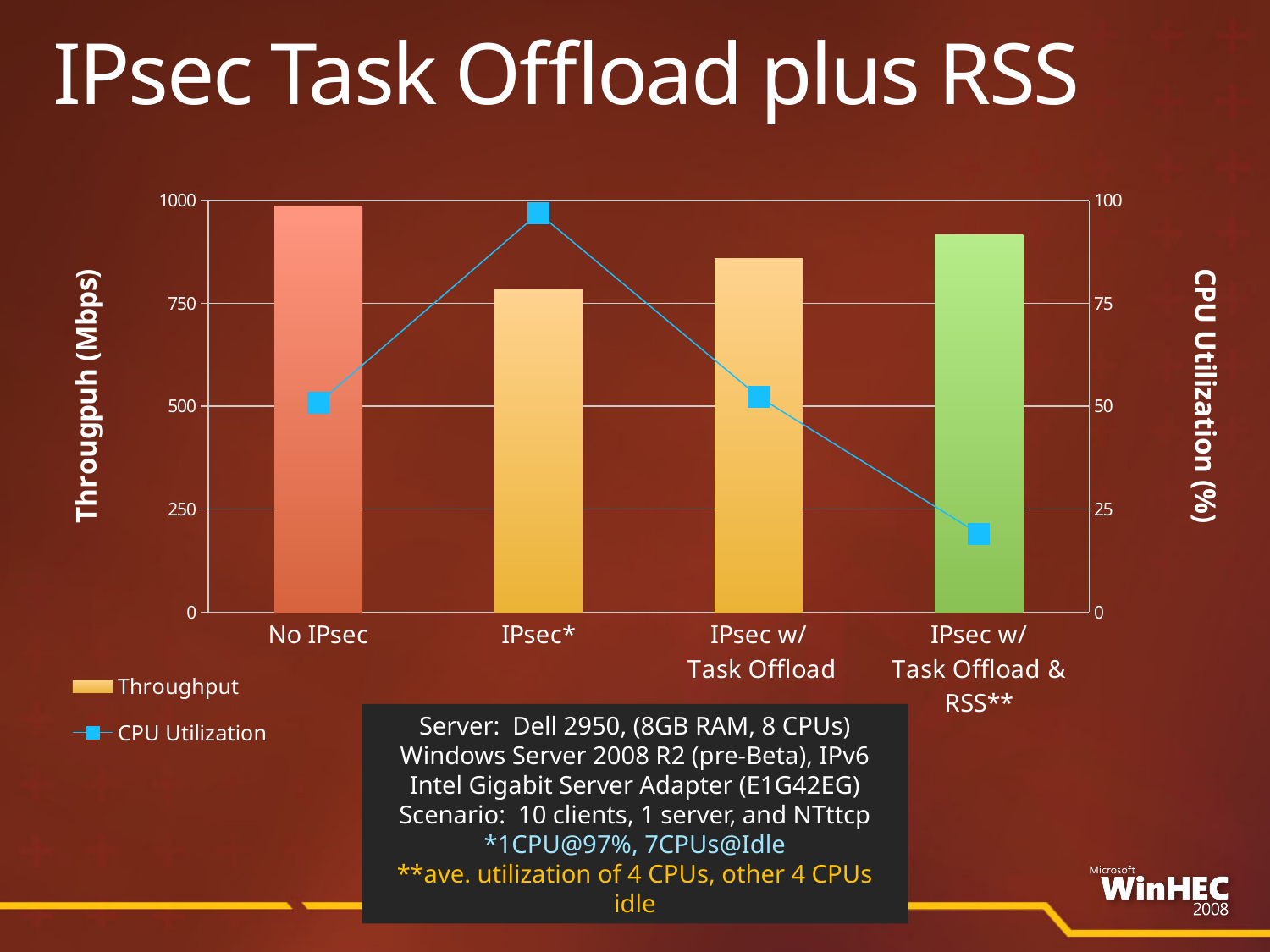
Which category has the highest throughput? No IPsec What kind of chart is shown on the slide? bar chart (with a line series) Is the CPU utilization for IPsec w/ Task Offload & RSS** greater or less than 25%? less Which has the higher throughput, No IPsec or IPsec*? No IPsec What is the title of the right-hand vertical axis? CPU Utilization (%) Is the CPU utilization for IPsec* greater or less than 75%? greater Which category has the lowest throughput? IPsec* How many categories are shown along the x axis? 4 How many series does the legend list? 2 Which category has the highest CPU utilization? IPsec* Is the throughput for No IPsec greater or less than 750 Mbps? greater Which category has the lowest CPU utilization? IPsec w/ Task Offload & RSS**